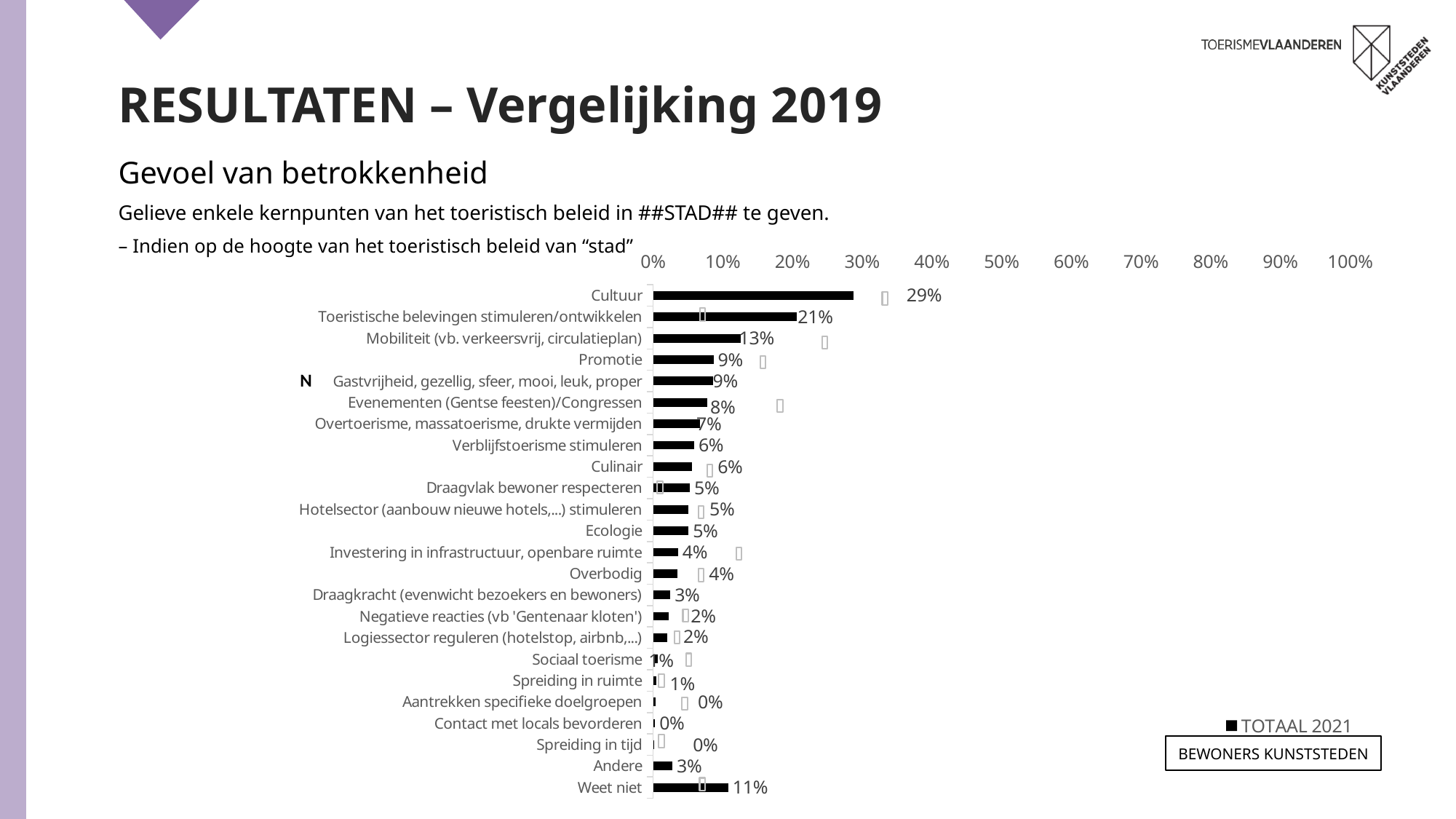
What is the value for Mobiliteit (vb. verkeersvrij, circulatieplan)? 13% What is the value for Cultuur? 29% Is the value for Cultuur greater or less than 20%? greater What is the value for Toeristische belevingen stimuleren/ontwikkelen? 21% Which is larger, the value for Promotie or the value for Ecologie? Promotie How many categories are shown on the chart? 24 What is the value for Weet niet? 11% What is the value for Andere? 3% Which category has the highest value? Cultuur What kind of chart is shown on the slide? bar chart What is the difference between the values for Cultuur and Toeristische belevingen stimuleren/ontwikkelen? 8% What series name is shown in the chart legend? TOTAAL 2021